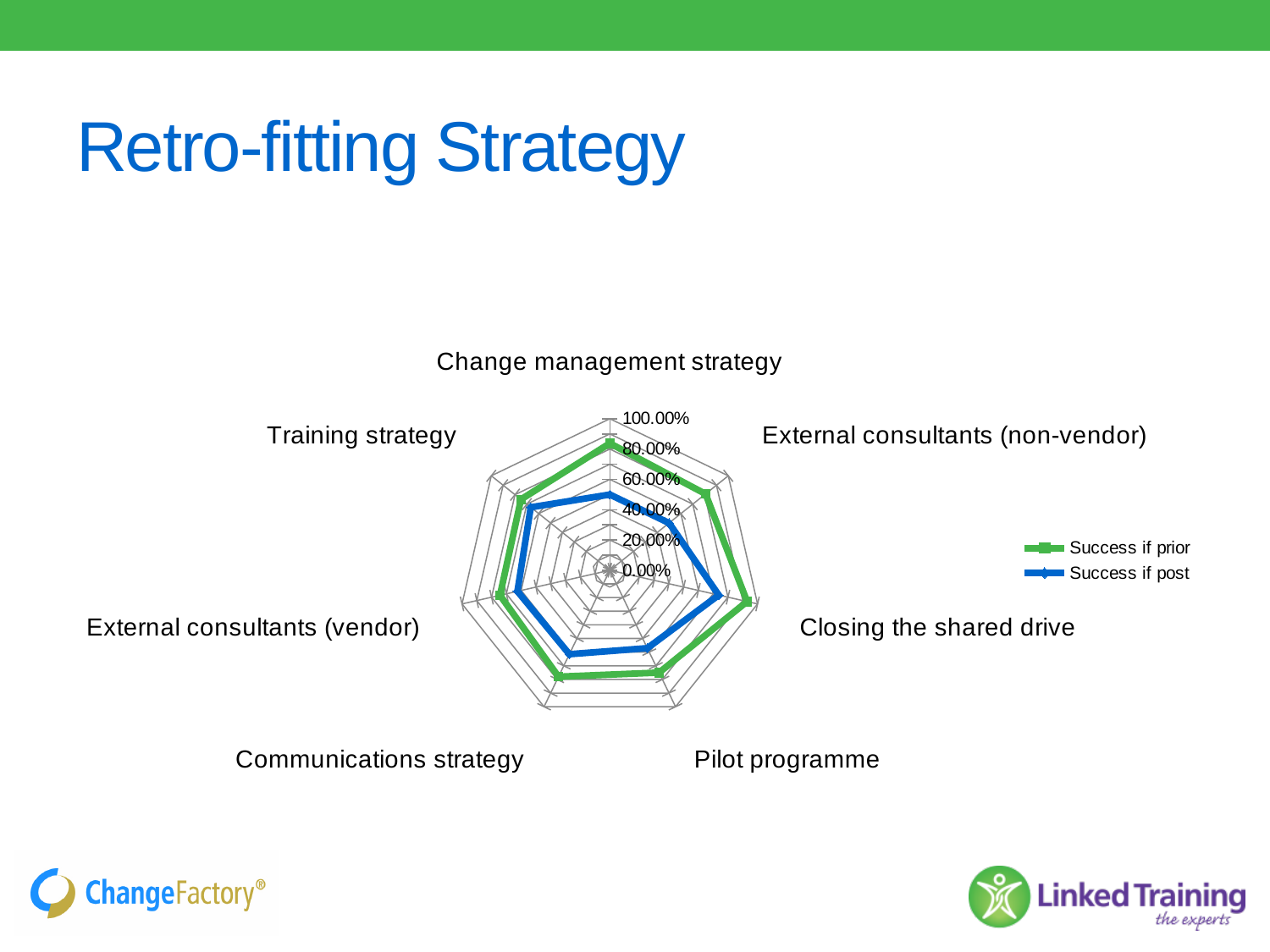
What are the two series named in the legend? Success if prior; Success if post What is the highest value shown on the radar chart's axis scale? 100.00% Which colour represents the 'Success if post' series? Blue What kind of chart is shown on the slide? Radar chart How many series does the legend list? 2 How many categories (axes) does the radar chart have? 7 For Change management strategy, which series has the larger value: Success if prior or Success if post? Success if prior Is the 'Success if prior' value for Change management strategy greater or less than 60.00%? greater Is the 'Success if prior' value for Closing the shared drive greater or less than 80.00%? greater Is the 'Success if post' value for Change management strategy greater or less than 60.00%? less